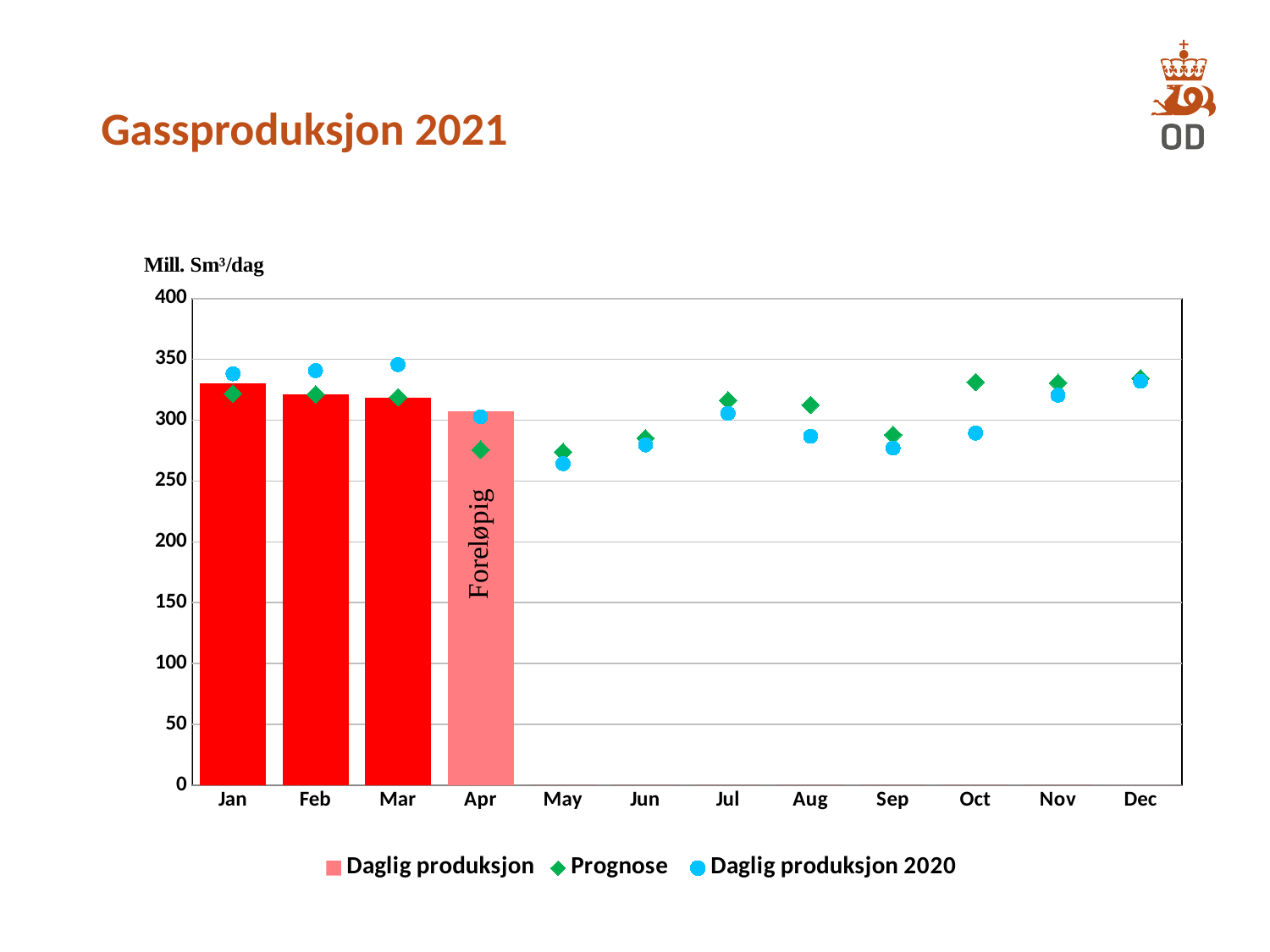
Is the Daglig produksjon value for Jan greater or less than 300? greater How many months are shown on the x axis? 12 Is the Daglig produksjon 2020 value for Sep greater or less than 300? less What label is written on the Apr bar? Foreløpig Is the Prognose value for May greater or less than 300? less Does the Prognose series rise or fall from May to Jul? rise In Aug, which is higher: Prognose or Daglig produksjon 2020? Prognose For how many months is a Daglig produksjon bar plotted? 4 How many series does the legend list? 3 Which month has the lowest Daglig produksjon bar? Apr Which month has the lowest Daglig produksjon 2020 value? May What kind of chart is shown on the slide? A bar chart combined with scatter/marker series